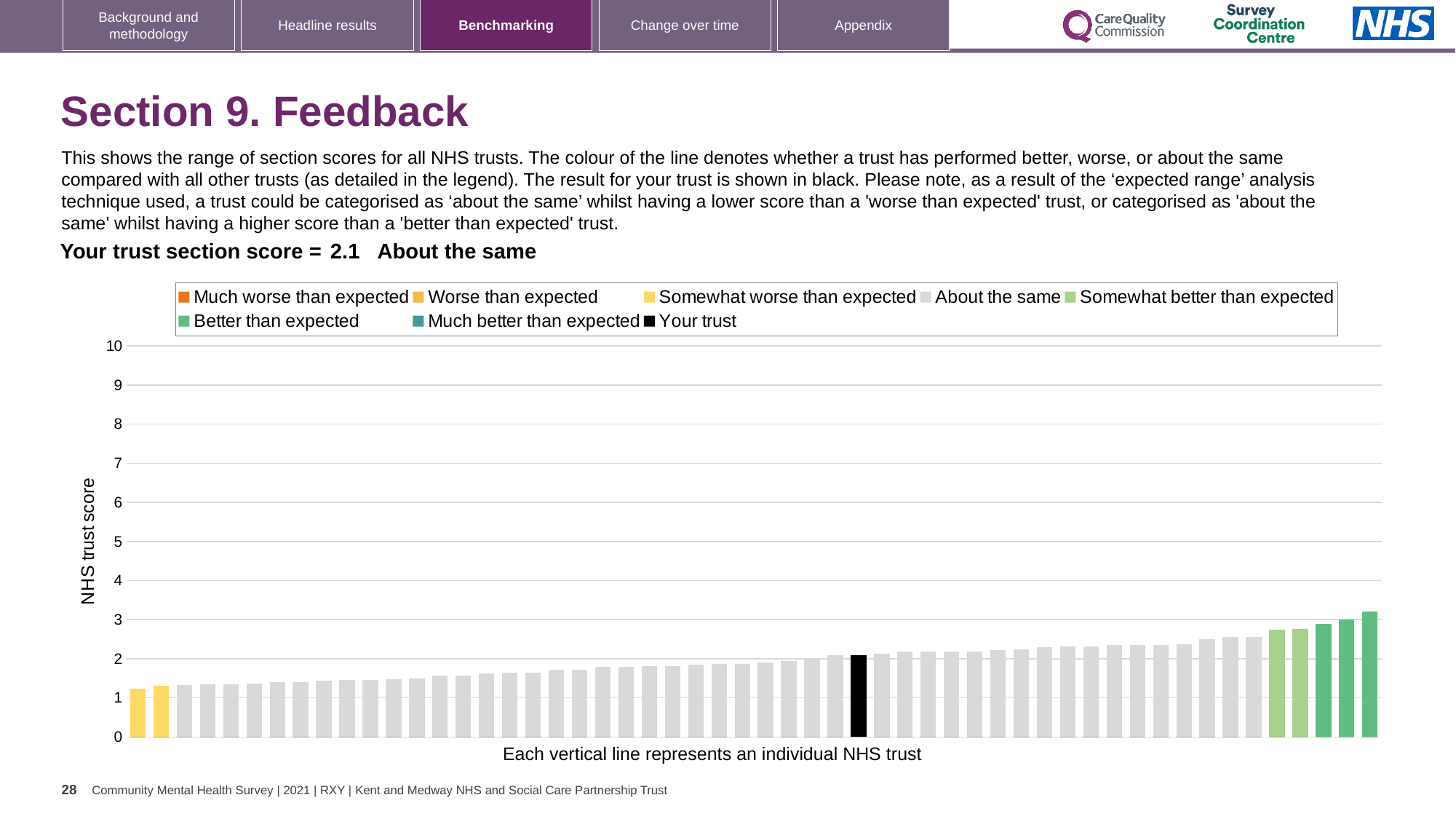
Is the value of the shortest bar in the chart greater or less than 2? less What kind of chart is used to show the NHS trust section scores? Bar chart Is the value for your trust (the black bar) greater or less than 3? less Do the bar values rise or fall moving from left to right along the chart? Rise Which performance category is your trust's section score placed in? About the same What is the section score for your trust shown on the slide? 2.1 What is the label on the vertical axis of the chart? NHS trust score Which legend category does the tallest bar in the chart belong to? Better than expected How many bars are coloured as 'Somewhat worse than expected'? 2 Which legend category does the shortest bar in the chart belong to? Somewhat worse than expected How many entries does the chart legend list? 8 Is the value of the tallest bar in the chart greater or less than 3? greater